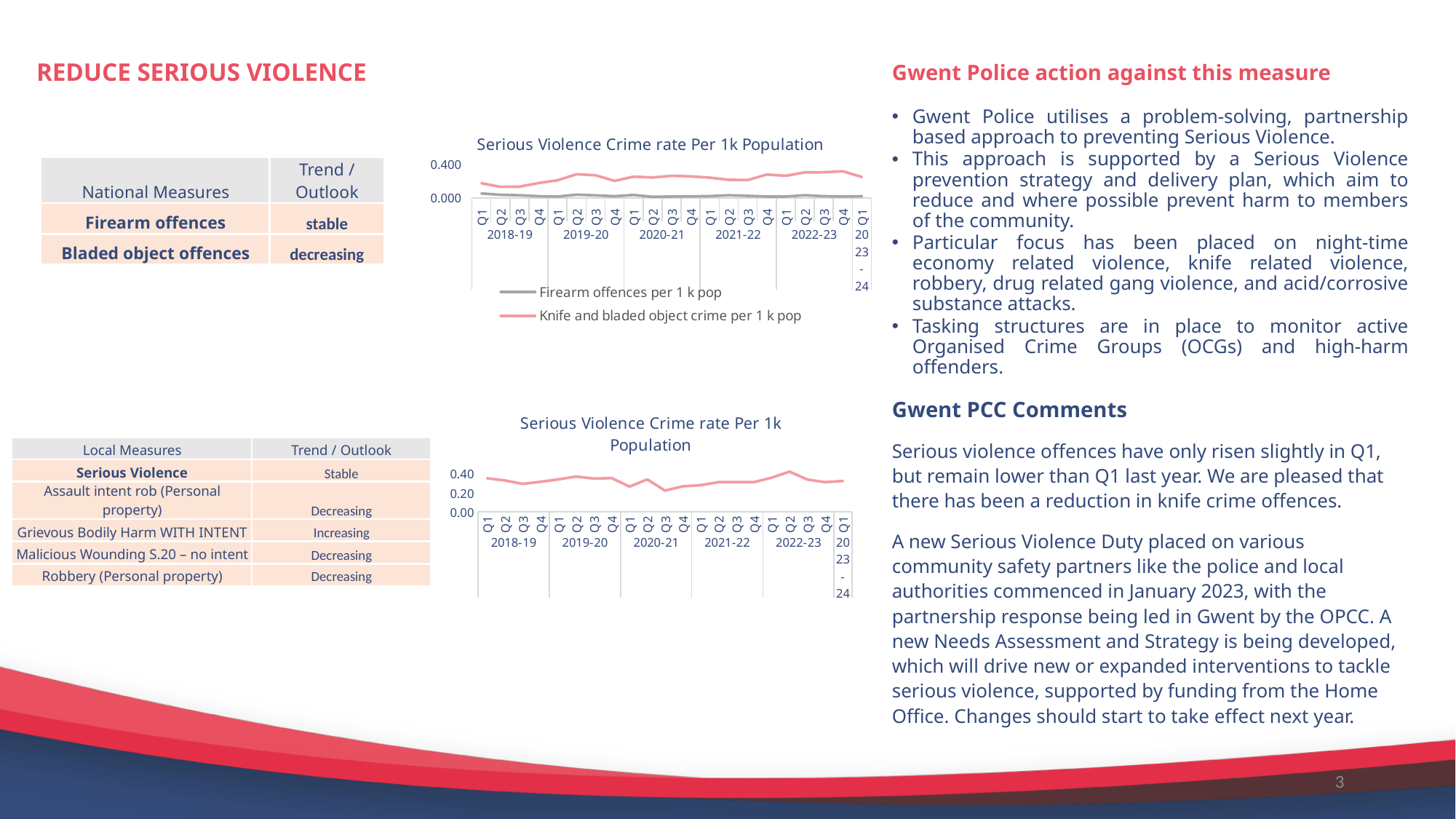
In the top chart, is the value for Firearm offences per 1 k pop in Q1 2018-19 greater or less than 0.400? less In the top chart, which series is plotted in pink? Knife and bladed object crime per 1 k pop How many financial years are labelled on the x axis of the bottom chart? 6 In the top chart, which series has higher values across the quarters: Firearm offences per 1 k pop or Knife and bladed object crime per 1 k pop? Knife and bladed object crime per 1 k pop What is the highest tick value shown on the y axis of the bottom chart? 0.40 What kind of chart is the top chart titled 'Serious Violence Crime rate Per 1k Population'? line chart How many series does the legend of the top chart list? 2 What kind of chart is the bottom chart titled 'Serious Violence Crime rate Per 1k Population'? line chart In the top chart, which series is plotted in grey? Firearm offences per 1 k pop In the bottom chart, is the value for Q1 2018-19 greater or less than 0.20? greater In the bottom chart, is the value for Q1 2021-22 greater or less than 0.20? greater